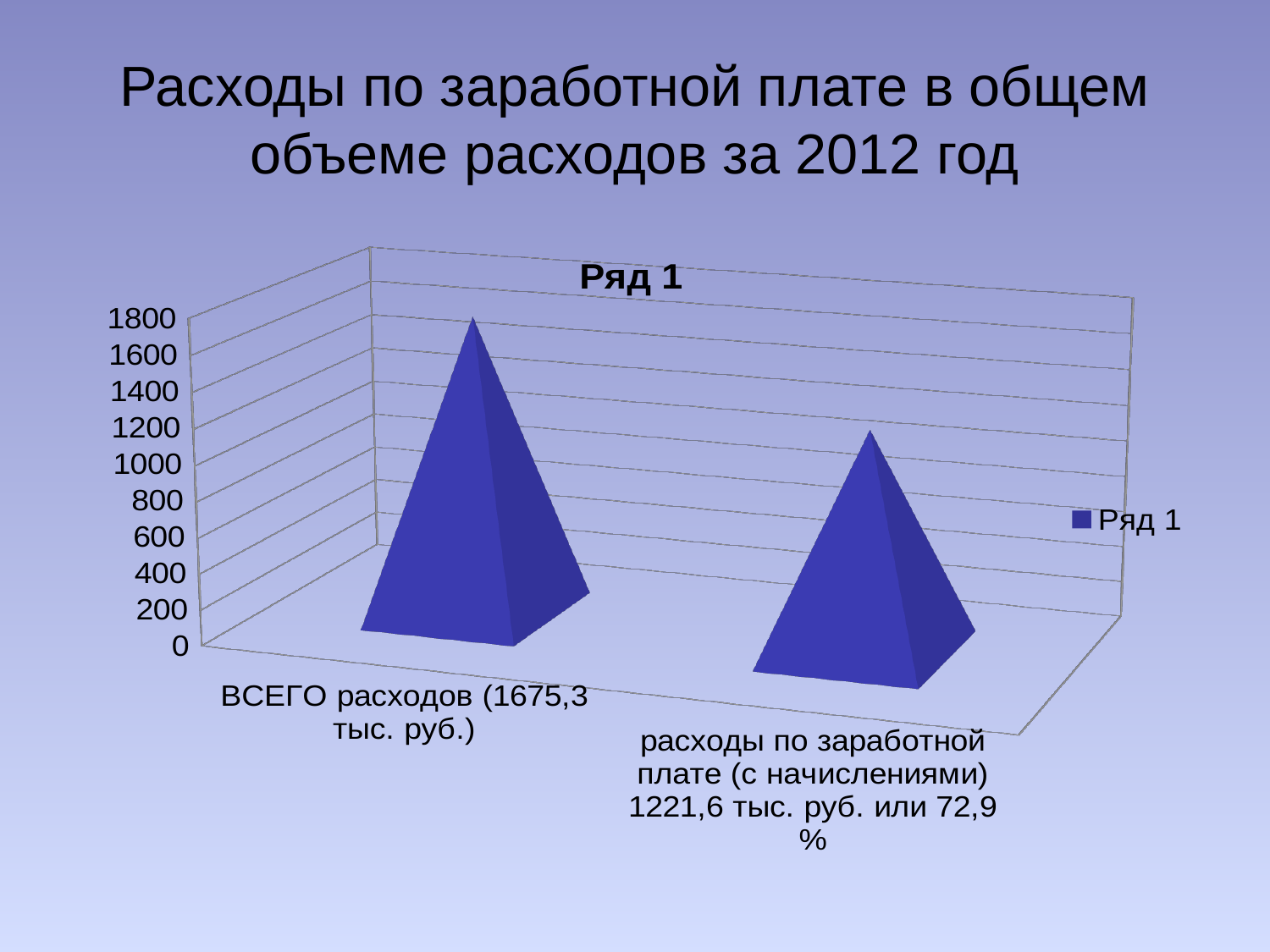
Which category has the highest value? ВСЕГО расходов What type of chart is shown on the slide? bar chart Is the value for расходы по заработной плате (с начислениями) greater or less than 1400? less How many categories are plotted in the chart? 2 What value is given for расходы по заработной плате (с начислениями)? 1221,6 тыс. руб. What is the title of the chart? Ряд 1 What value is given for ВСЕГО расходов? 1675,3 тыс. руб. What share of total expenses do the salary expenses (расходы по заработной плате) make up, according to the category label? 72,9 % How many series does the legend list? 1 What is the difference between ВСЕГО расходов and расходы по заработной плате (с начислениями)? 453,7 тыс. руб. What is the name of the series shown in the legend? Ряд 1 Which category has the lowest value? расходы по заработной плате (с начислениями)